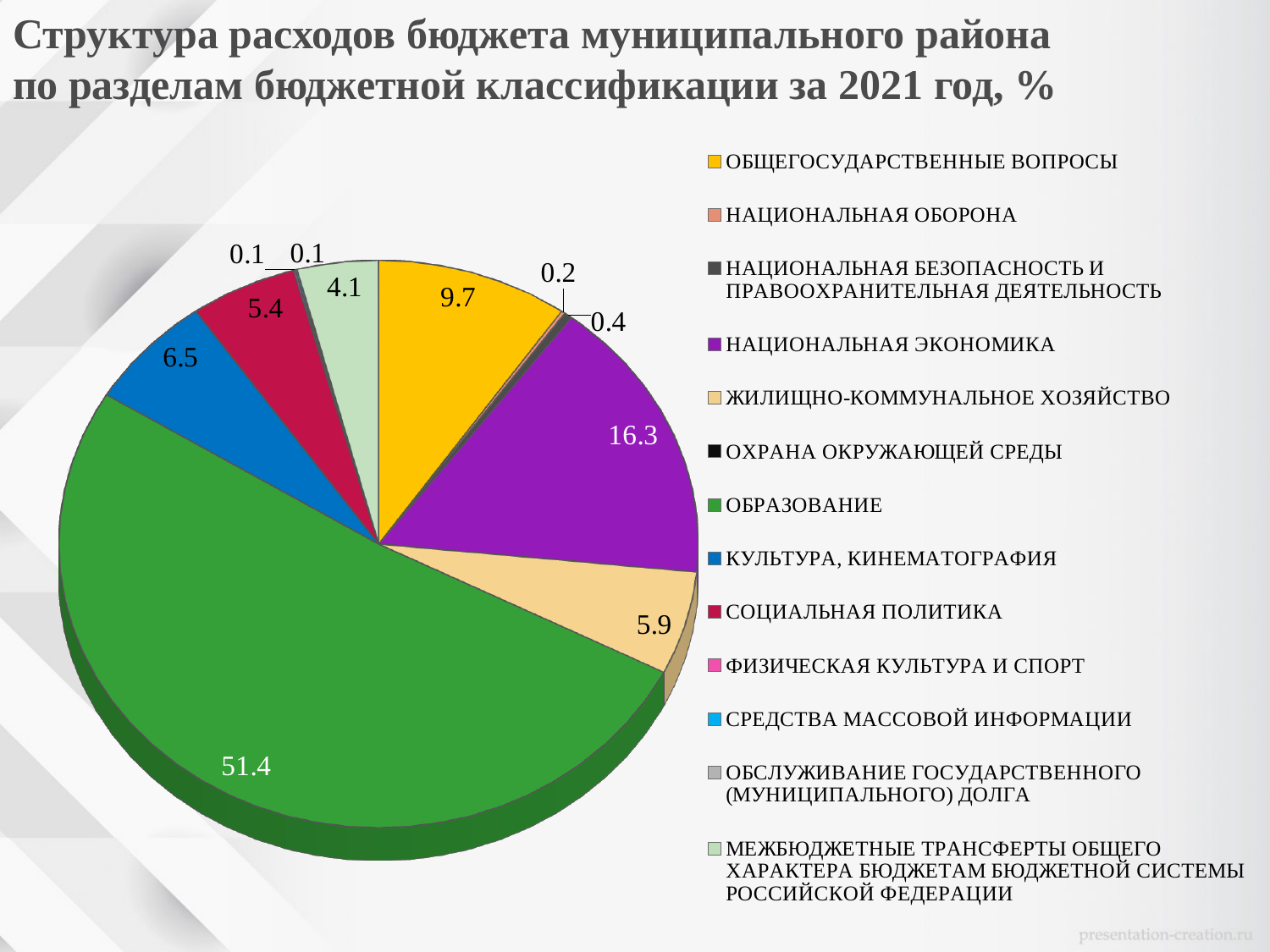
What is the value shown for ОБЩЕГОСУДАРСТВЕННЫЕ ВОПРОСЫ? 9.7 What kind of chart is shown on the slide? pie chart Which section has the largest share of the budget expenditure? ОБРАЗОВАНИЕ What is the value shown for КУЛЬТУРА, КИНЕМАТОГРАФИЯ? 6.5 What is the difference between the values for НАЦИОНАЛЬНАЯ ЭКОНОМИКА and ОБЩЕГОСУДАРСТВЕННЫЕ ВОПРОСЫ? 6.6 Which is larger, the value for КУЛЬТУРА, КИНЕМАТОГРАФИЯ or the value for СОЦИАЛЬНАЯ ПОЛИТИКА? КУЛЬТУРА, КИНЕМАТОГРАФИЯ What is the value shown for ЖИЛИЩНО-КОММУНАЛЬНОЕ ХОЗЯЙСТВО? 5.9 What is the value shown for СОЦИАЛЬНАЯ ПОЛИТИКА? 5.4 What share of the pie does ОБРАЗОВАНИЕ account for? 51.4 What is the value shown for НАЦИОНАЛЬНАЯ ЭКОНОМИКА? 16.3 What colour is the slice for ОБРАЗОВАНИЕ? green How many categories does the legend list? 13